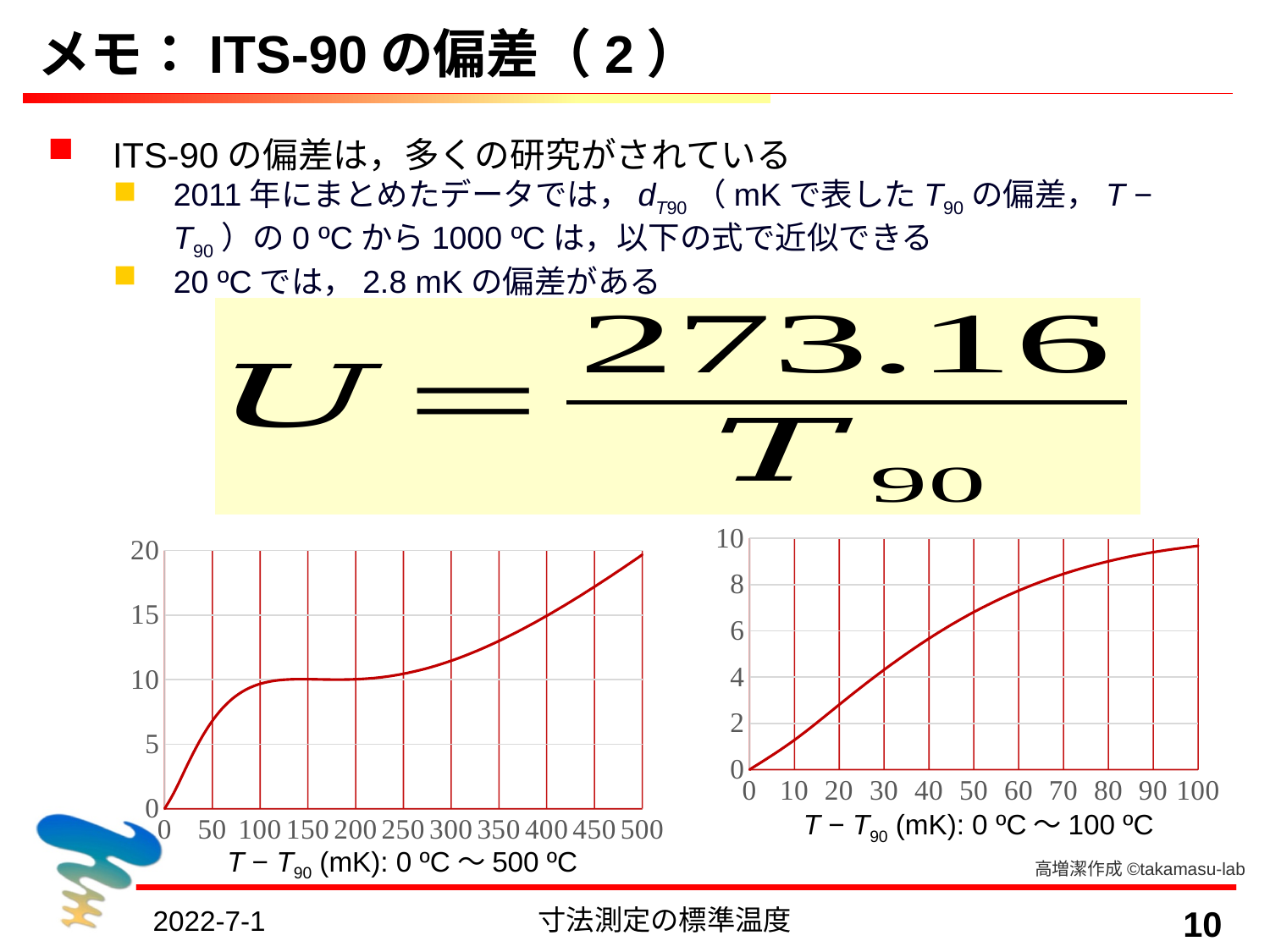
In the left chart (0 ºC ～ 500 ºC), is the value at x = 300 greater or less than 10? greater What kind of chart is the right chart (0 ºC ～ 100 ºC)? line chart In the left chart (0 ºC ～ 500 ºC), is the value at x = 450 greater or less than 15? greater What is the x-axis label of the right chart? T − T90 (mK): 0 ºC ～ 100 ºC In the left chart (0 ºC ～ 500 ºC), do the values rise or fall overall as the x axis increases from 0 to 500? rise In the right chart (0 ºC ～ 100 ºC), do the values rise or fall as the x axis increases from 0 to 100? rise In the left chart (0 ºC ～ 500 ºC), is the value at x = 50 greater or less than 5? greater What kind of chart is the left chart (0 ºC ～ 500 ºC)? line chart